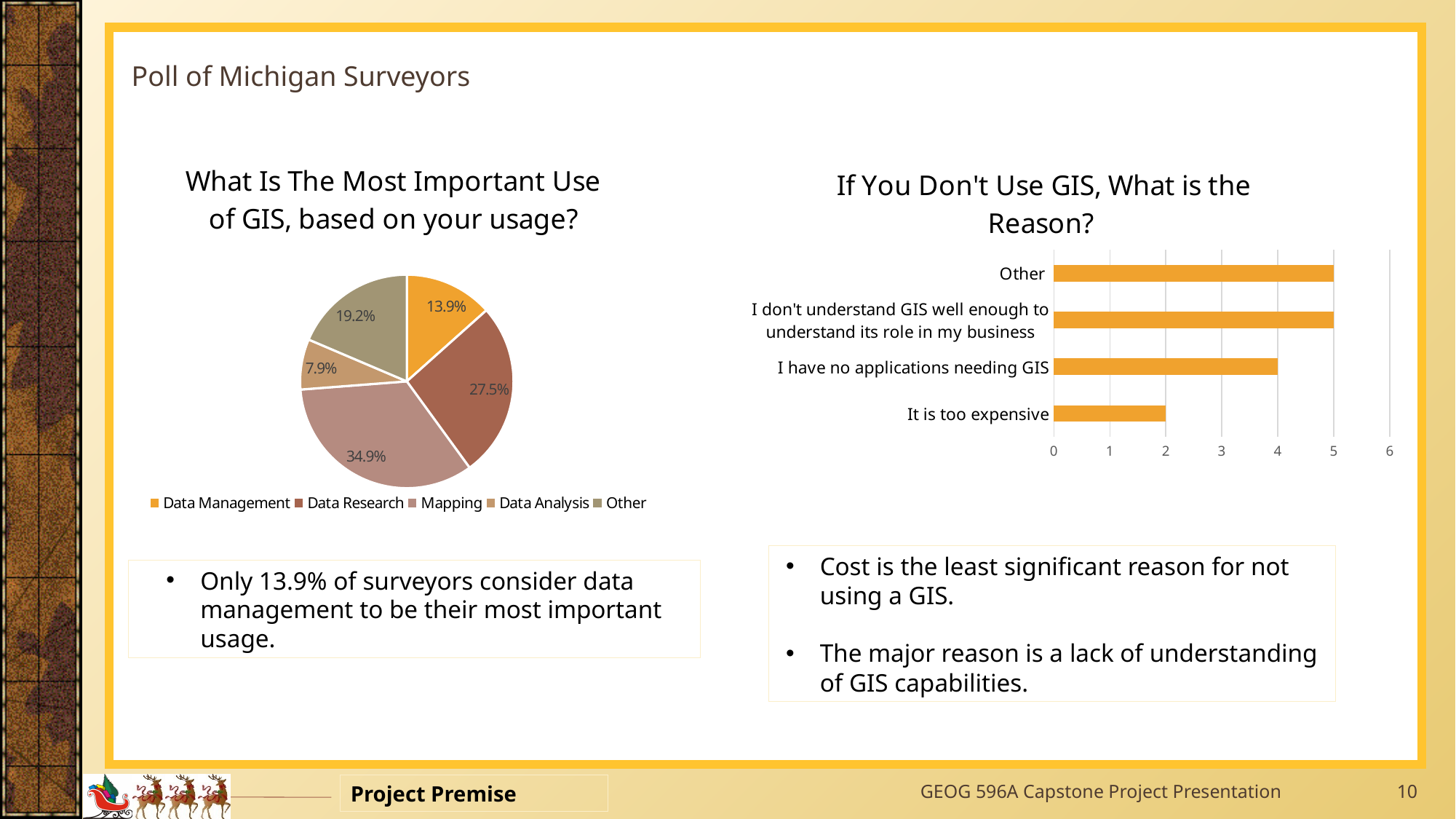
In the bar chart 'If You Don't Use GIS, What is the Reason?', what is the value for 'I have no applications needing GIS'? 4 In the bar chart 'If You Don't Use GIS, What is the Reason?', what is the value for 'It is too expensive'? 2 In the bar chart 'If You Don't Use GIS, What is the Reason?', which reason has the lowest value? It is too expensive In the pie chart 'What Is The Most Important Use of GIS, based on your usage?', what is the difference in percentage points between Data Research and Data Management? 13.6 In the bar chart 'If You Don't Use GIS, What is the Reason?', which is larger: 'I have no applications needing GIS' or 'It is too expensive'? I have no applications needing GIS In the pie chart 'What Is The Most Important Use of GIS, based on your usage?', what percentage is shown for Data Analysis? 7.9% In the pie chart 'What Is The Most Important Use of GIS, based on your usage?', which category has the largest share? Mapping In the pie chart 'What Is The Most Important Use of GIS, based on your usage?', how many categories does the legend list? 5 In the pie chart 'What Is The Most Important Use of GIS, based on your usage?', which category has the smallest share? Data Analysis What type of chart is the chart on the right side of the slide, titled 'If You Don't Use GIS, What is the Reason?'? Bar chart In the bar chart 'If You Don't Use GIS, What is the Reason?', how many reasons are plotted? 4 In the pie chart 'What Is The Most Important Use of GIS, based on your usage?', what percentage is shown for Mapping? 34.9%